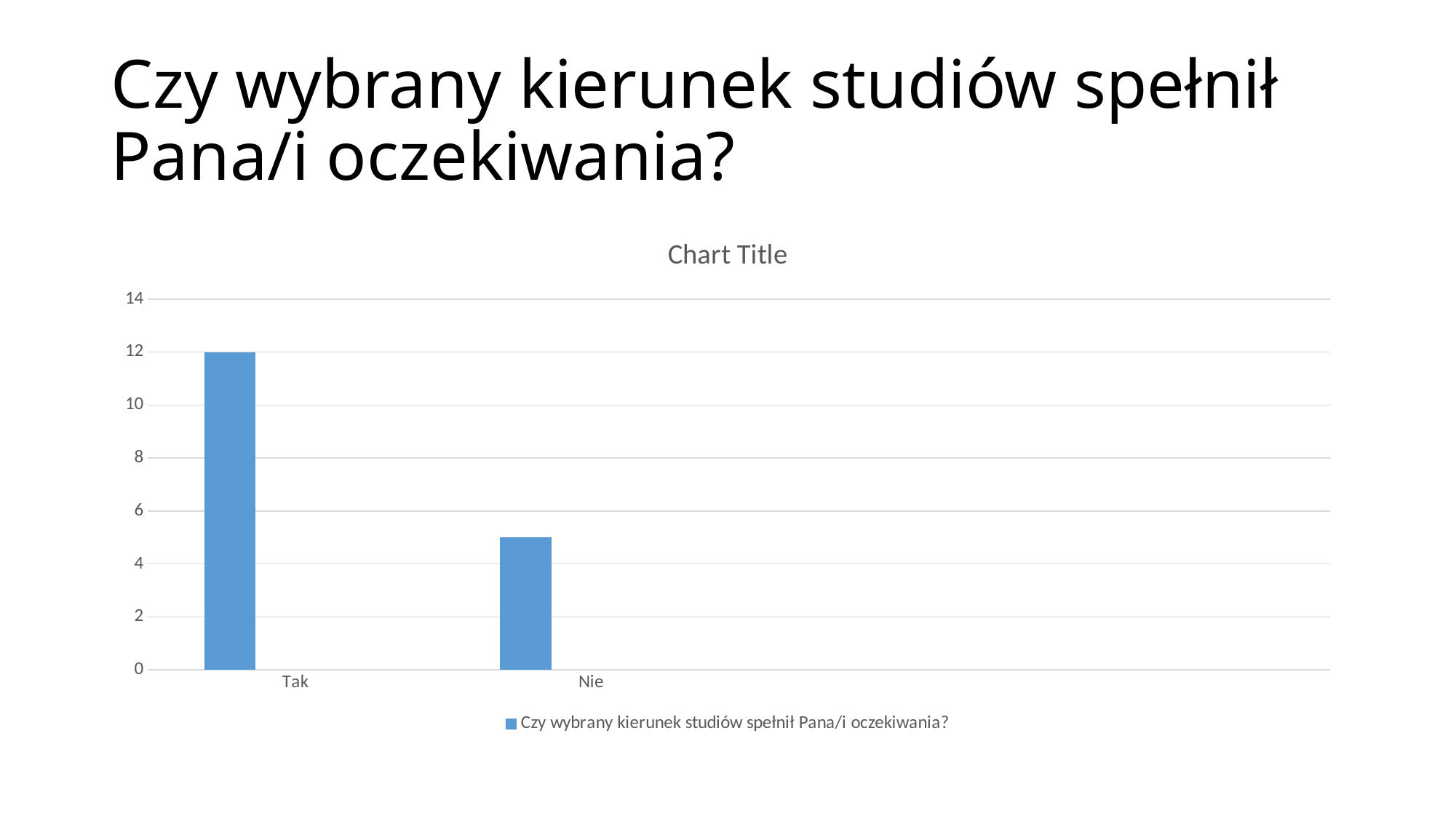
Is the value for Nie greater or less than 6? less What is the value for Tak? 12 Which category has the highest value? Tak What is the legend entry for the series? Czy wybrany kierunek studiów spełnił Pana/i oczekiwania? What kind of chart is shown on the slide? bar chart Is the value for Tak greater or less than 10? greater Is the value for Nie greater or less than 4? greater How many series does the legend list? 1 How many categories are shown on the x axis? 2 Which category has the lowest value? Nie What is the title shown above the chart? Chart Title Which is larger, the value for Tak or the value for Nie? Tak